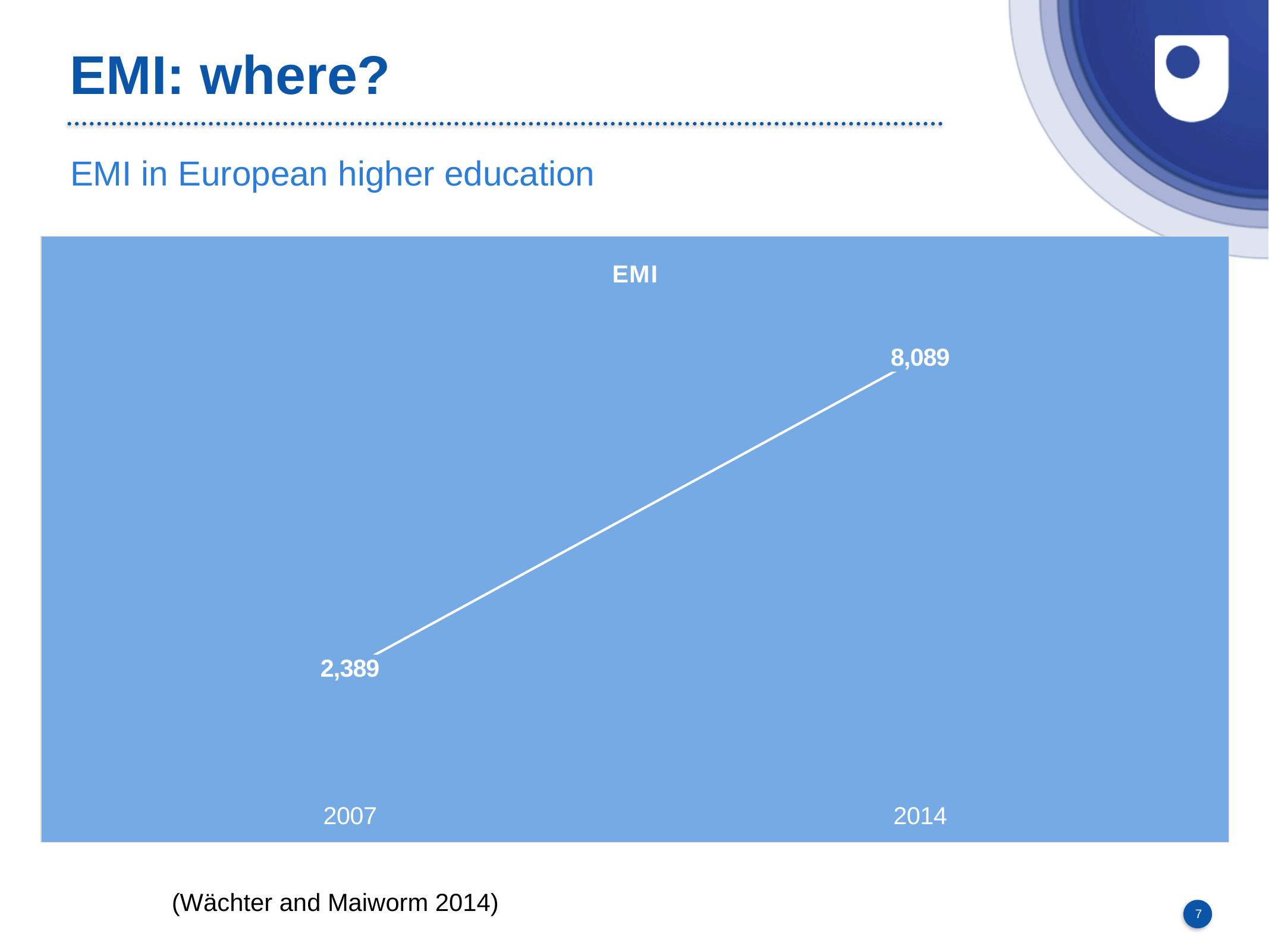
What is the difference between the values for 2014 and 2007? 5,700 Which year has the lowest value? 2007 Do the values rise or fall from 2007 to 2014? rise Which year has the highest value? 2014 What is the value for 2014? 8,089 What colour is the line on the chart? white What is the value for 2007? 2,389 What is the title of the chart? EMI Which is larger, the value for 2007 or the value for 2014? 2014 What kind of chart is shown? line chart How many data points are plotted on the chart? 2